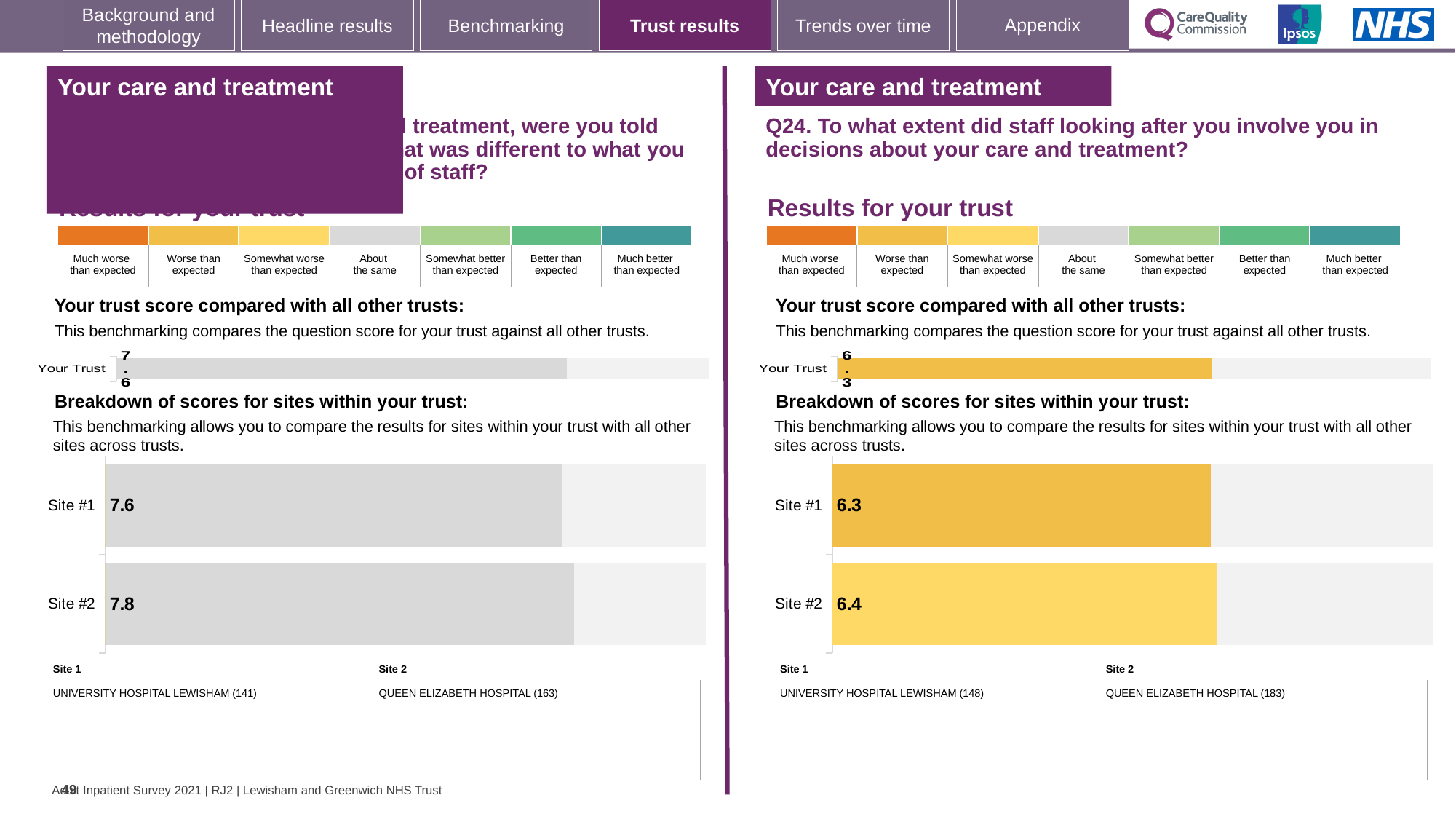
On the left-hand 'Your trust score compared with all other trusts' chart, what is the score for Your Trust? 7.6 On the right-hand (Q24) site breakdown chart, what is the difference between the Site #2 and Site #1 scores? 0.1 On the right-hand (Q24) site breakdown chart, which site has the lower score? Site #1 On the left-hand site breakdown chart, what is the difference between the Site #2 and Site #1 scores? 0.2 On the right-hand (Q24) 'Your trust score compared with all other trusts' chart, what is the score for Your Trust? 6.3 On the left-hand site breakdown chart, which site has the higher score? Site #2 On the left-hand site breakdown chart, what is the score for Site #2? 7.8 On the right-hand (Q24) site breakdown chart, what is the score for Site #1? 6.3 On the right-hand (Q24) site breakdown chart, what is the score for Site #2? 6.4 On the left-hand site breakdown chart, what is the score for Site #1? 7.6 What type of chart is used for the site breakdown on the left-hand side of the slide? Bar chart How many sites are shown on the right-hand (Q24) site breakdown chart? 2